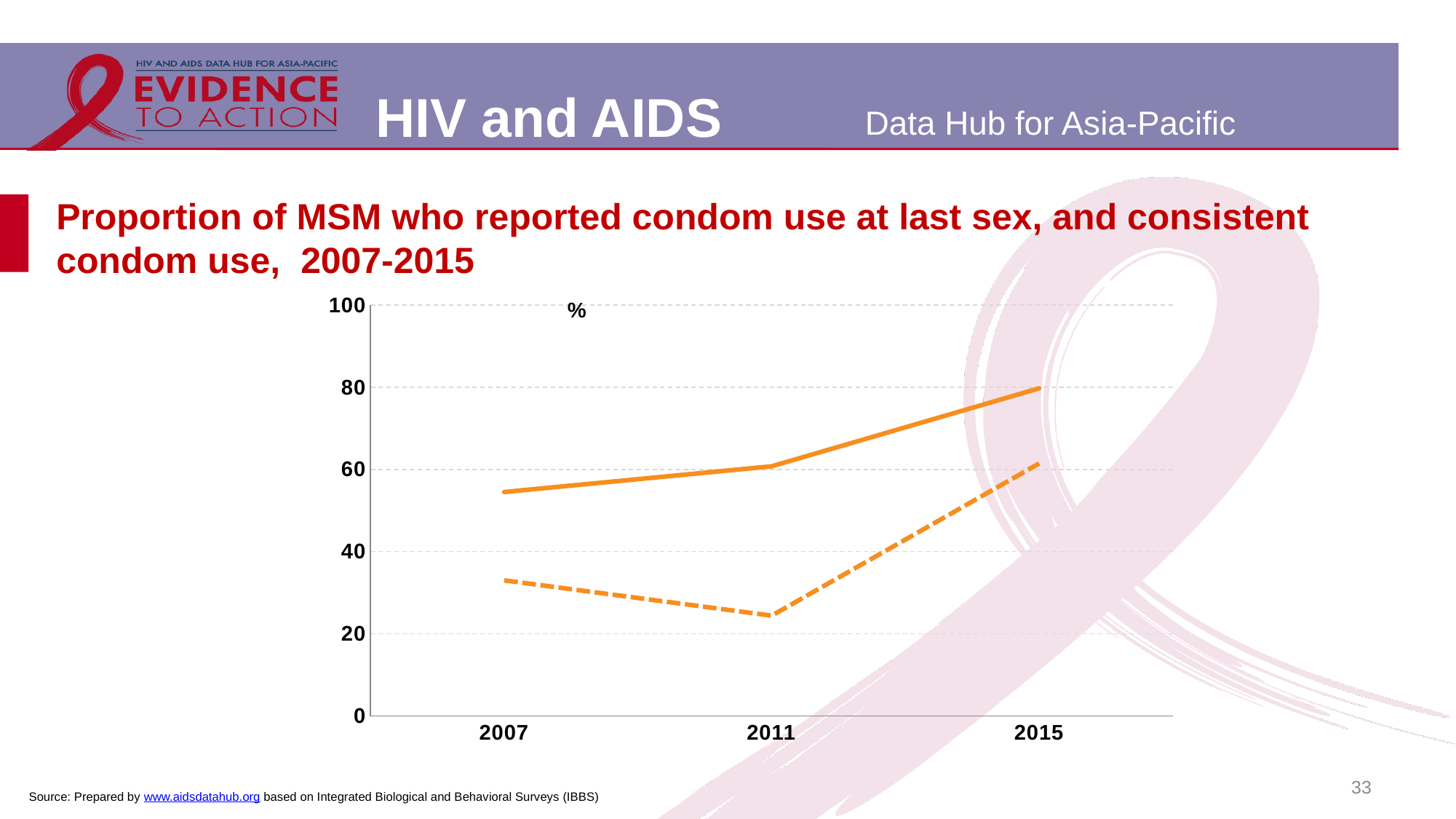
Does the solid line rise or fall from 2007 to 2015? Rise How many years are shown on the x axis of the chart? 3 Which years are shown on the x axis of the chart? 2007, 2011, 2015 In 2007, which line has the higher value, the solid line or the dashed line? Solid line Is the value of the dashed line in 2007 greater or less than 20? greater In which year does the dashed line reach its lowest value? 2011 What kind of chart is shown on the slide? Line chart Is the value of the dashed line in 2011 greater or less than 40? less What is the maximum value shown on the y axis of the chart? 100 Is the value of the solid line in 2007 greater or less than 40? greater In which year does the solid line reach its highest value? 2015 In which year does the dashed line reach its highest value? 2015